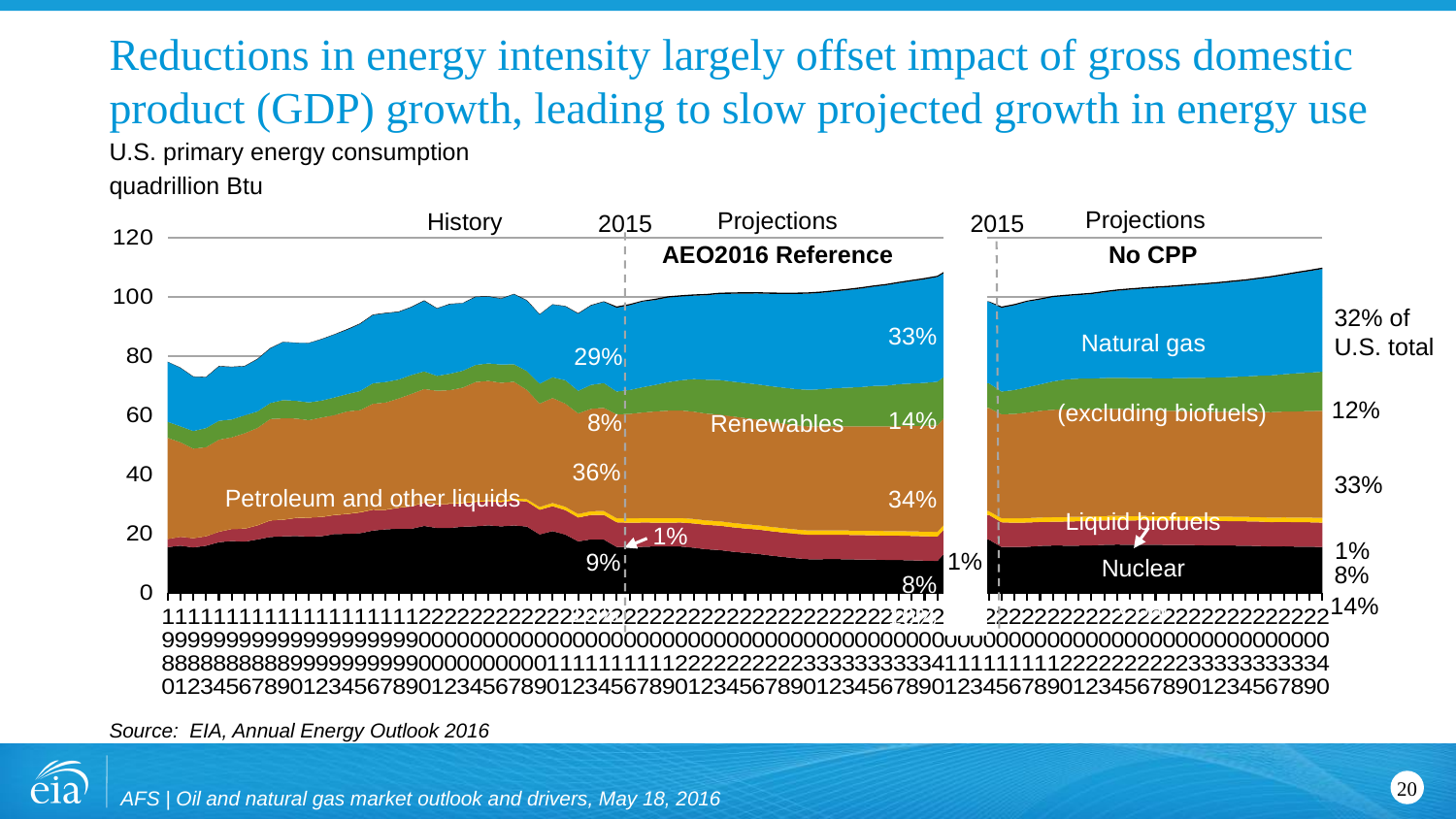
Which chart shows a larger end-of-projection share for renewables, AEO2016 Reference or No CPP? AEO2016 Reference What kind of chart is used on this slide to show U.S. primary energy consumption? Stacked area chart In the AEO2016 Reference chart, what share does natural gas reach at the end of the projection period? 33% In the AEO2016 Reference chart, is total U.S. primary energy consumption in 2015 greater or less than 80 quadrillion Btu? greater In the AEO2016 Reference chart, by how many percentage points does the natural gas share grow from 2015 to the end of the projection? 4 percentage points In the AEO2016 Reference chart, what is the share of renewables (excluding biofuels) in 2015? 8% In the No CPP chart, what is the end-of-projection share for renewables? 12% In the AEO2016 Reference chart, what share of U.S. primary energy consumption does natural gas account for in 2015? 29% In the No CPP chart, what share of the U.S. total does natural gas account for at the end of the projection? 32% What unit is used on the y-axis of the charts? quadrillion Btu In the AEO2016 Reference chart, does total primary energy consumption rise or fall over the projection period after 2015? Rise In the AEO2016 Reference chart, what share does petroleum and other liquids hold in 2015? 36%